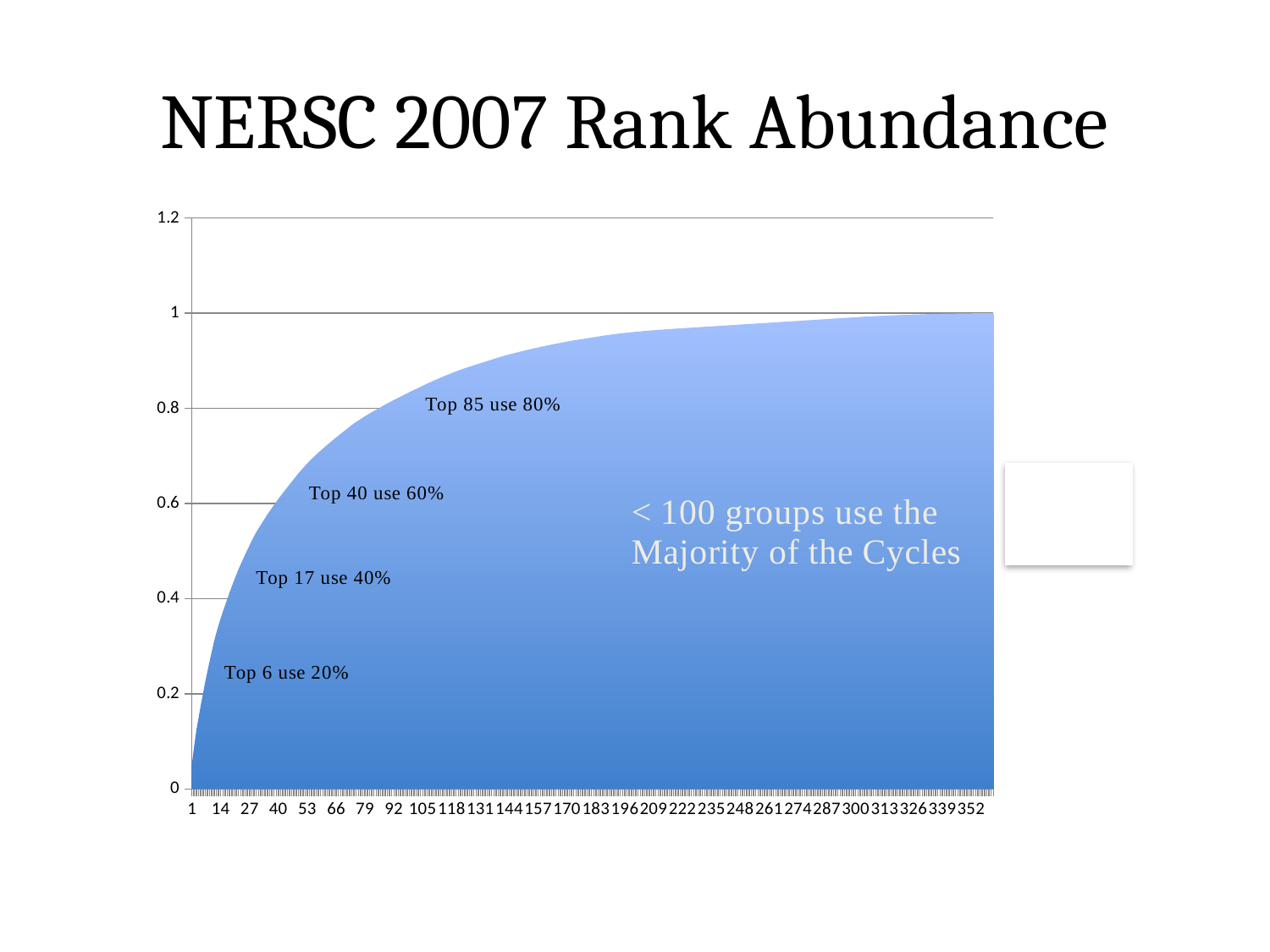
Is the value at rank 1 greater or less than 0.2? less Does the plotted value rise or fall as rank increases along the x axis? rise What is the highest tick value shown on the y axis? 1.2 What is the title of the slide's chart? NERSC 2007 Rank Abundance Is the value at rank 352 greater or less than 1.2? less According to the chart annotation, how many top groups use 80% of the cycles? 85 What kind of chart is shown on the slide? area chart Is the value at rank 183 greater or less than 0.8? greater What is the difference between the share used by the top 85 groups and the share used by the top 40 groups, according to the annotations? 20% According to the chart annotation, what share of cycles do the top 17 groups use? 40% According to the chart annotation, what share of cycles do the top 6 groups use? 20% According to the chart annotation, how many top groups use 60% of the cycles? 40